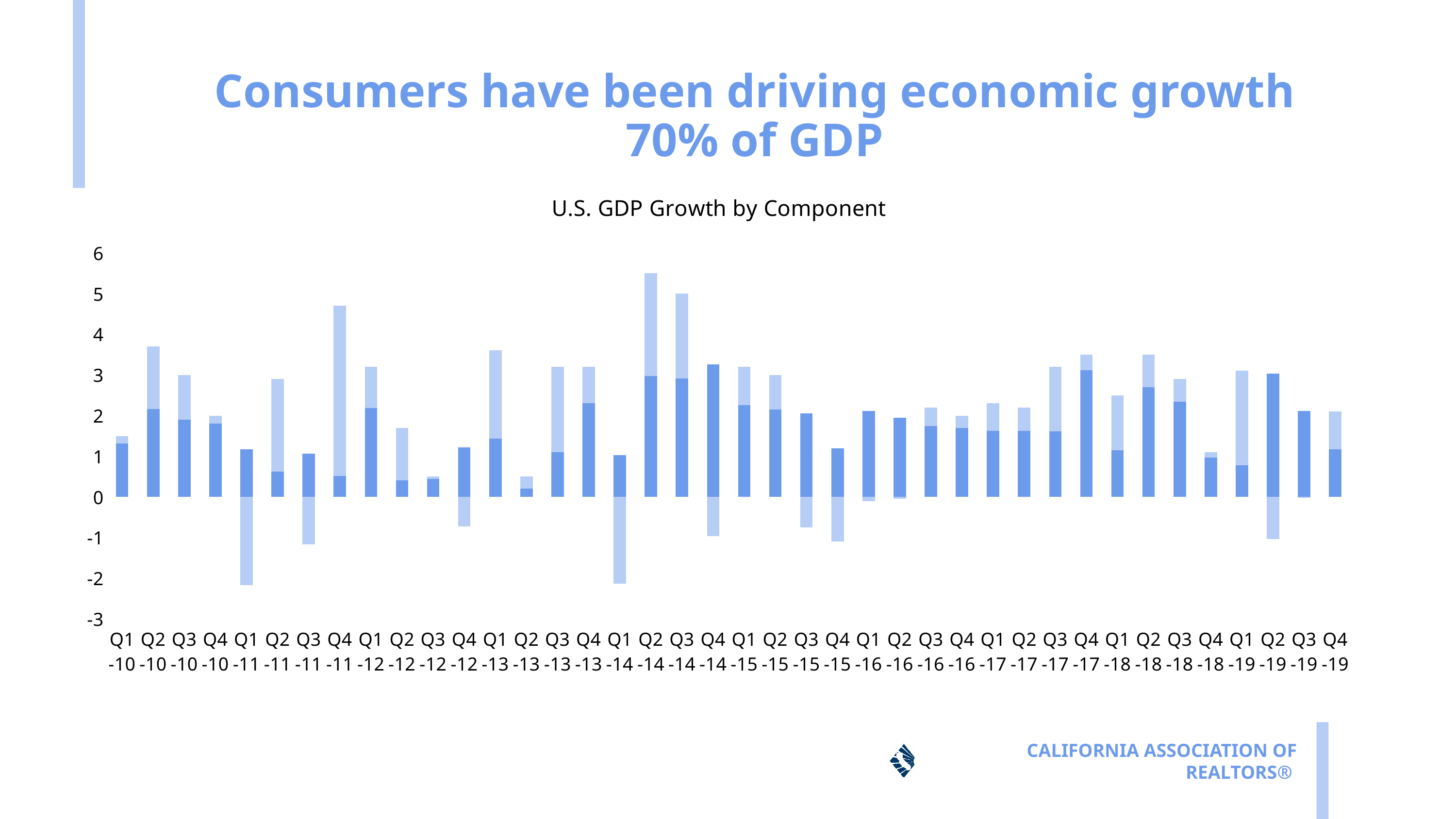
What is the title of the chart? U.S. GDP Growth by Component Is the top of the bar for Q4-11 greater or less than 4? greater Which bar reaches higher, Q2-14 or Q3-14? Q2-14 How many quarters are shown along the x axis of the chart? 40 Is the top of the bar for Q3-12 greater or less than 1? less Is the top of the bar for Q4-17 greater or less than 3? greater Which quarter has the tallest bar in the chart? Q2-14 Which bar reaches higher, Q4-11 or Q1-12? Q4-11 What kind of chart is shown on the slide? bar chart What is the highest value shown on the vertical axis? 6